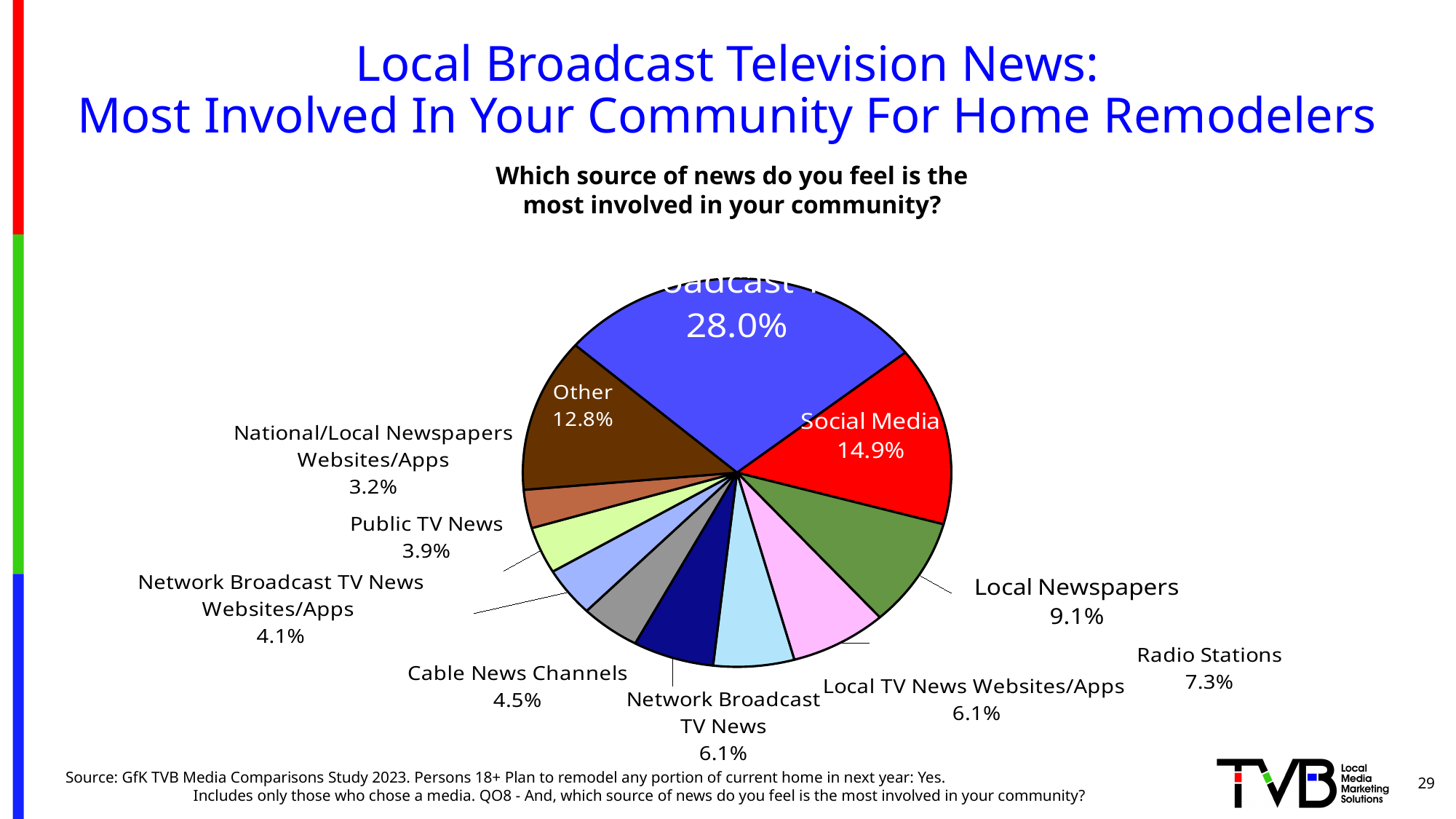
What percentage is shown on the largest slice of the pie? 28.0% What is the value for Network Broadcast TV News Websites/Apps? 4.1% What is the value shown for the Other slice? 12.8% Which category has the smallest slice of the pie? National/Local Newspapers Websites/Apps What percentage of the pie does Social Media account for? 14.9% What is the value for Radio Stations? 7.3% Which is larger, Radio Stations or Public TV News? Radio Stations What is the difference between the Social Media and Local Newspapers percentages? 5.8% What kind of chart is shown on the slide? pie chart How many slices does the pie chart have? 11 What percentage is shown for Cable News Channels? 4.5% What percentage is shown for Local Newspapers? 9.1%